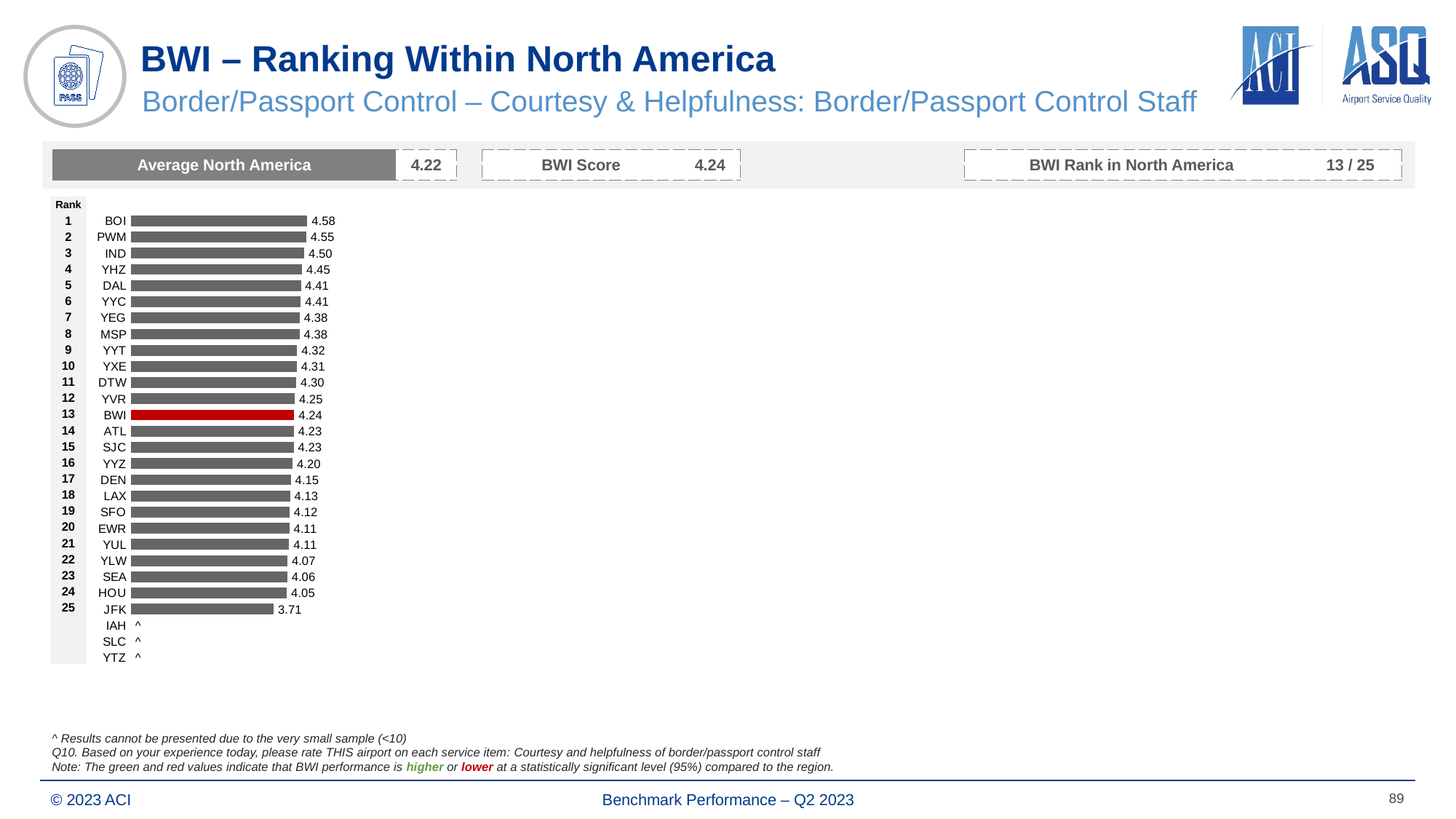
What is the value for DTW? 4.30 What is the difference between the values for BOI and JFK? 0.87 What is the value for JFK? 3.71 Which airport has the highest value? BOI How many airports have a bar plotted in the chart? 25 Which has a larger value, DEN or HOU? DEN Which airport's bar is highlighted in red? BWI What is the value for BWI? 4.24 What kind of chart is shown? Bar chart What is the difference between the values for BWI and YVR? 0.01 Which airport has the lowest plotted value? JFK Which has a larger value, PWM or IND? PWM